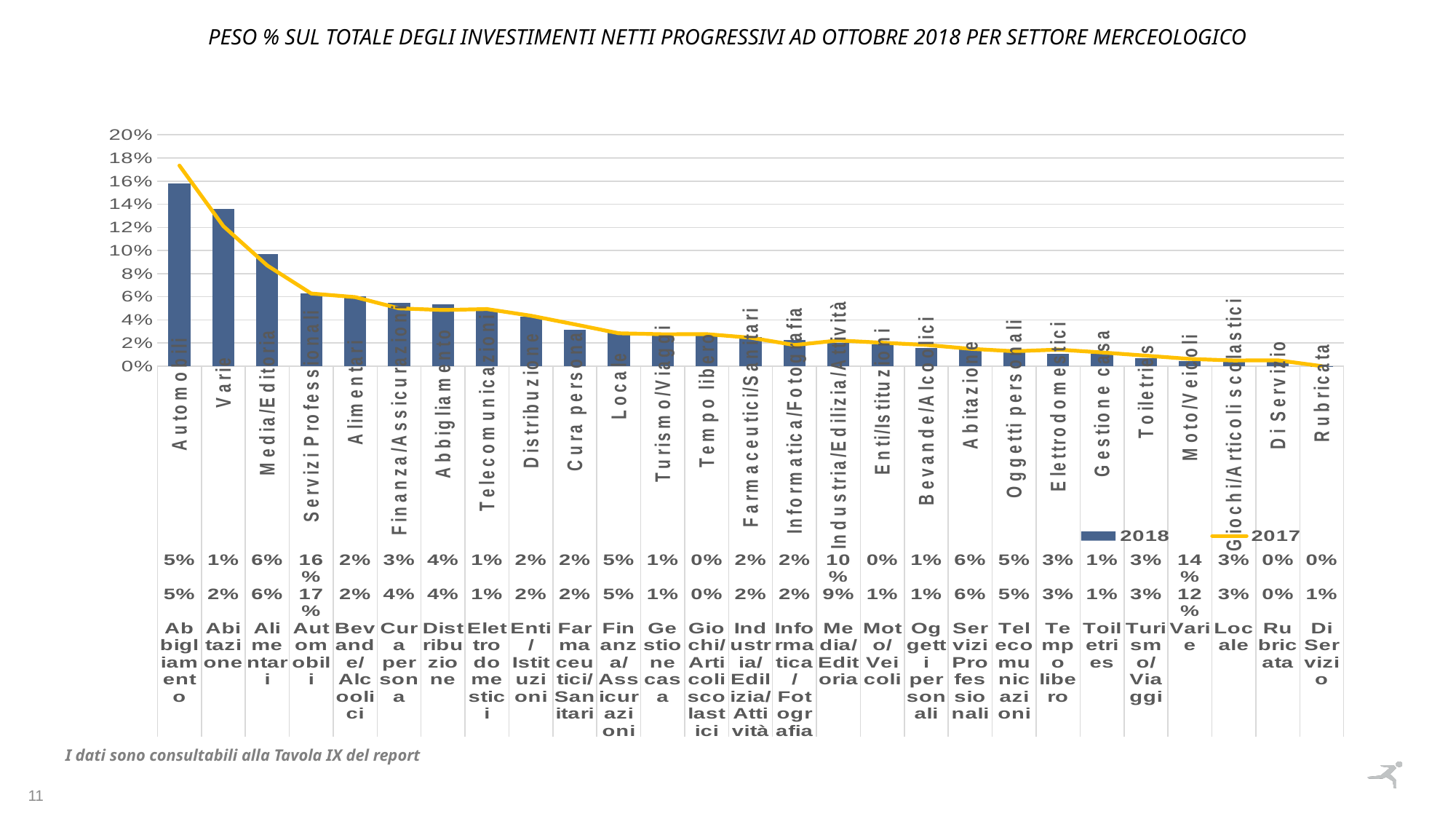
What is the 2018 value for Varie? 14% Do the 2018 bar values rise or fall moving from left to right along the x axis? fall How many sectors (categories) are plotted along the x axis? 27 Is the 2018 bar for Media/Editoria greater or less than 8%? greater How many series does the legend list? 2 What is the 2017 value for Automobili? 17% Which sector has the highest 2018 value? Automobili Which is larger, the 2018 bar for Automobili or the 2018 bar for Varie? Automobili What kind of chart is shown on the slide? A bar chart with a line series Which series is drawn as a line rather than bars? 2017 What is the 2018 value for Automobili? 16% What is the difference between the 2017 and 2018 values for Automobili? 1%